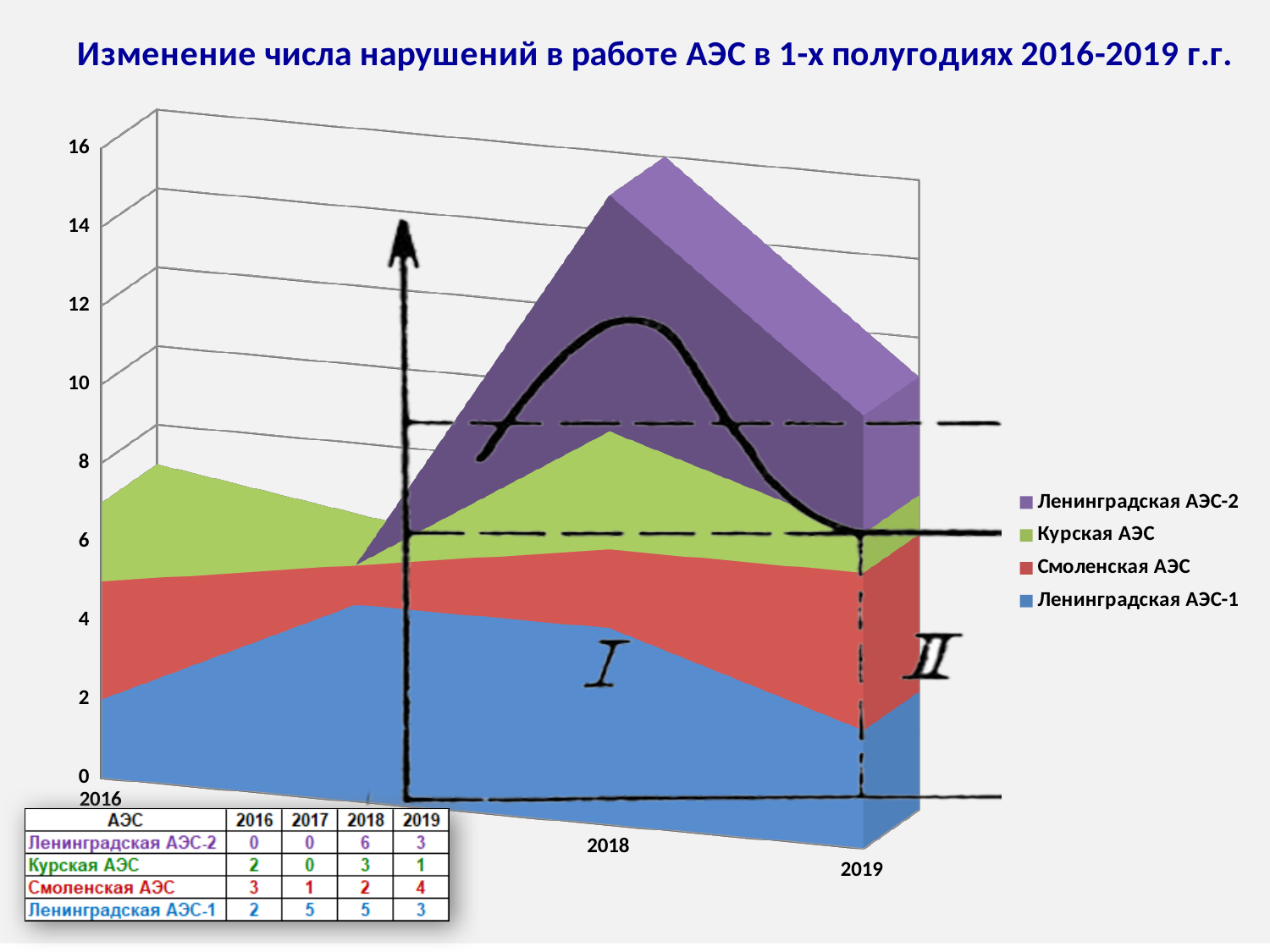
In which year is the total number of violations across all plants highest? 2018 What kind of chart is shown on the slide? area chart In which year does Ленинградская АЭС-1 have its lowest value? 2016 Which colour represents Курская АЭС in the legend? green What is the value for Ленинградская АЭС-1 in 2017? 5 What is the difference between the values for Ленинградская АЭС-1 in 2017 and 2016? 3 In 2018, which has the larger value: Курская АЭС or Смоленская АЭС? Курская АЭС What is the total number of violations across all four plants in 2018? 16 How many series does the legend list? 4 What is the value for Ленинградская АЭС-2 in 2018? 6 How many violations did Смоленская АЭС have in 2019? 4 What is the total number of violations across all four plants in 2019? 11